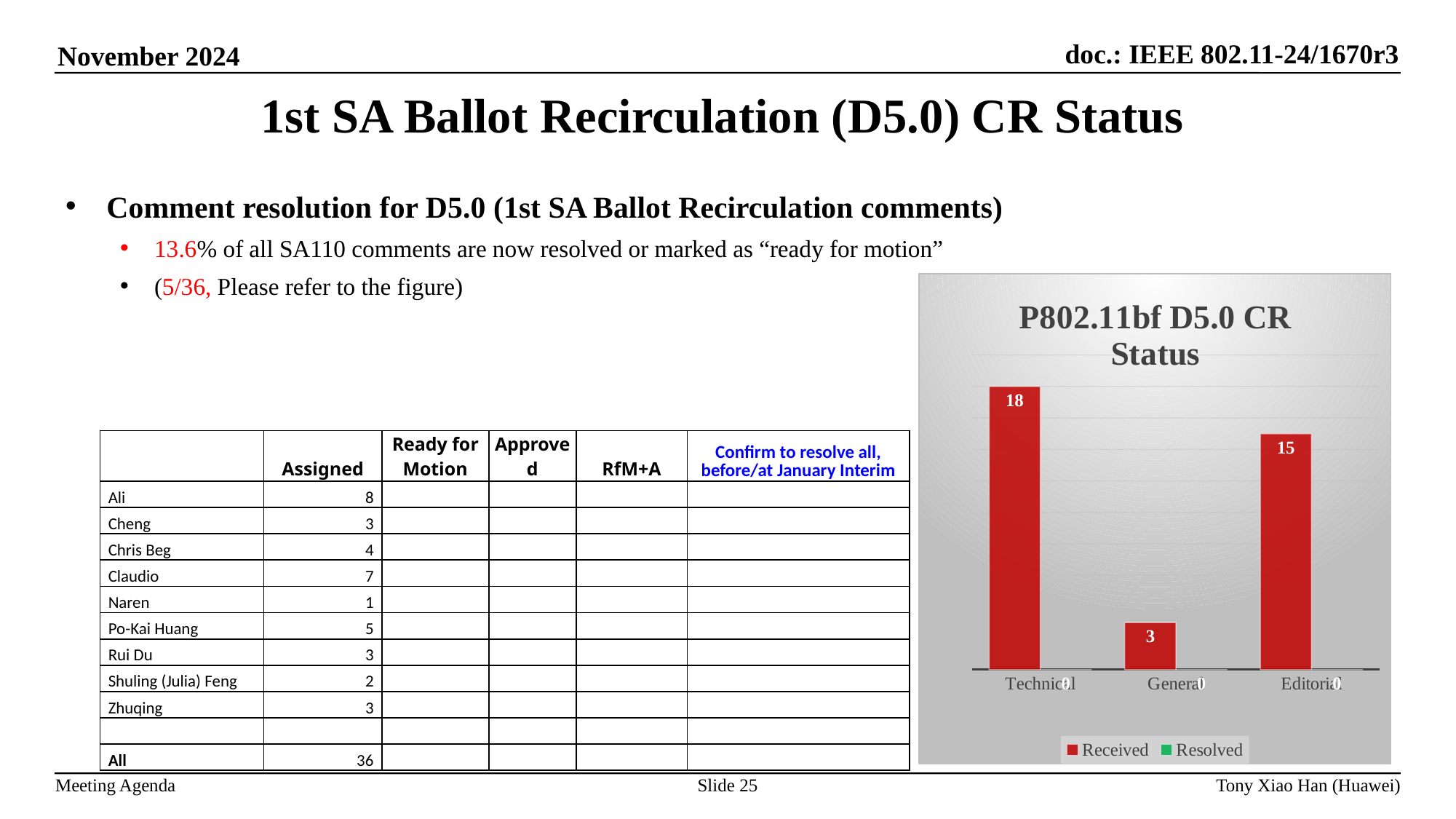
What is the Received value for General? 3 Which has a larger Received value, General or Editorial? Editorial What is the title of the chart? P802.11bf D5.0 CR Status Which category has the highest Received value? Technical What is the difference between the Received values for Technical and Editorial? 3 What are the two series named in the chart legend? Received and Resolved Which category has the lowest Received value? General What is the Received value for Editorial? 15 What kind of chart is shown on the slide? bar chart What is the Received value for Technical? 18 How many categories are shown on the x axis of the chart? 3 How many series does the chart legend list? 2